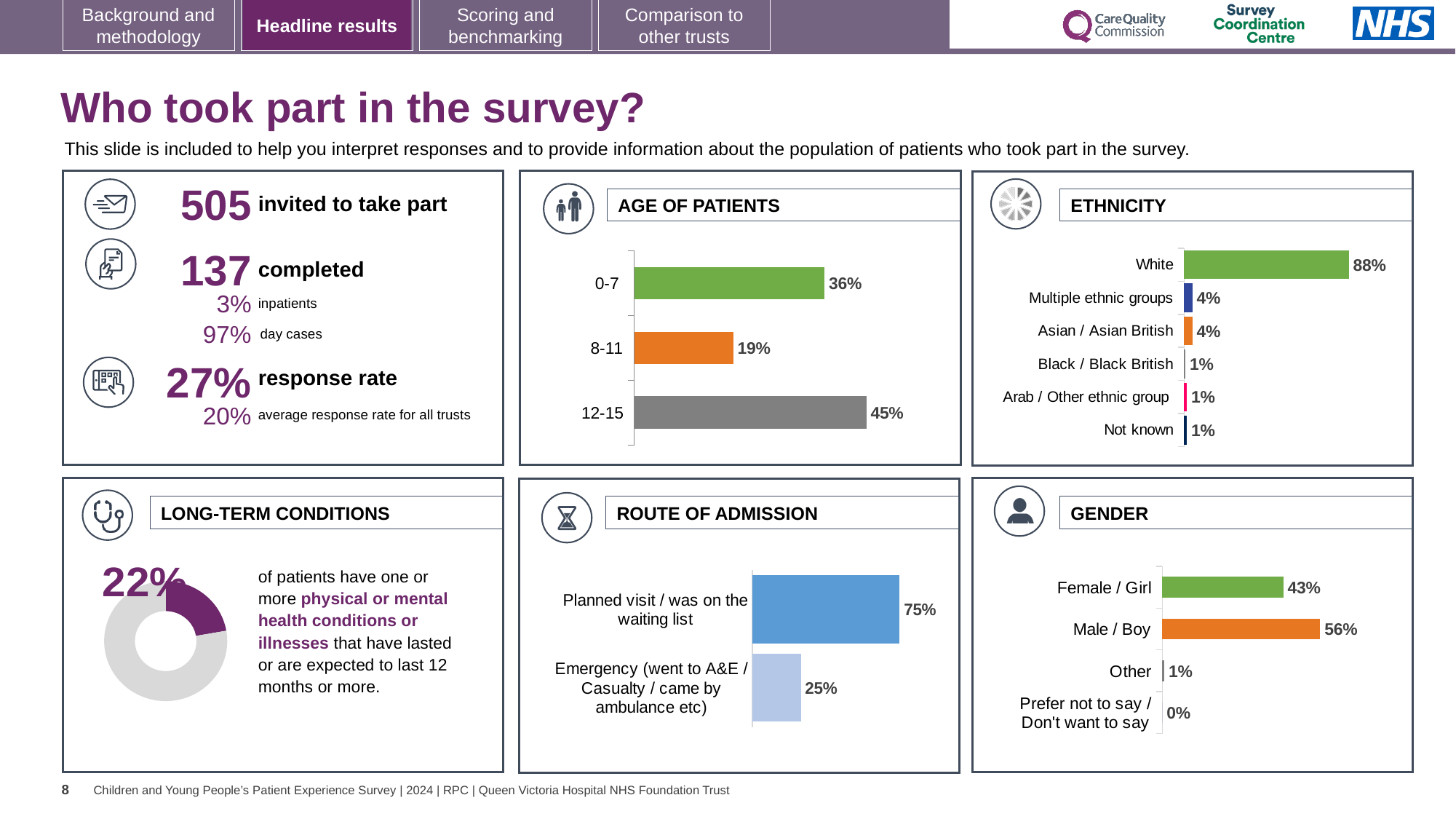
What kind of chart is used in the LONG-TERM CONDITIONS panel? Doughnut chart In the ETHNICITY chart, how many ethnicity categories are shown? 6 In the AGE OF PATIENTS chart, which age group has the lowest percentage? 8-11 In the GENDER chart, what percentage of patients answered Prefer not to say / Don't want to say? 0% In the AGE OF PATIENTS chart, what percentage of patients were aged 12-15? 45% In the AGE OF PATIENTS chart, what is the difference between the 0-7 and 8-11 percentages? 17% In the ETHNICITY chart, what percentage of patients were White? 88% In the ROUTE OF ADMISSION chart, what percentage of patients came via Emergency (went to A&E / Casualty / came by ambulance etc)? 25% In the GENDER chart, which is larger, Female / Girl or Male / Boy? Male / Boy In the LONG-TERM CONDITIONS chart, what share of patients have one or more long-term conditions? 22% In the ROUTE OF ADMISSION chart, what is the difference between the Planned visit and Emergency percentages? 50% In the ETHNICITY chart, which category has the highest percentage? White